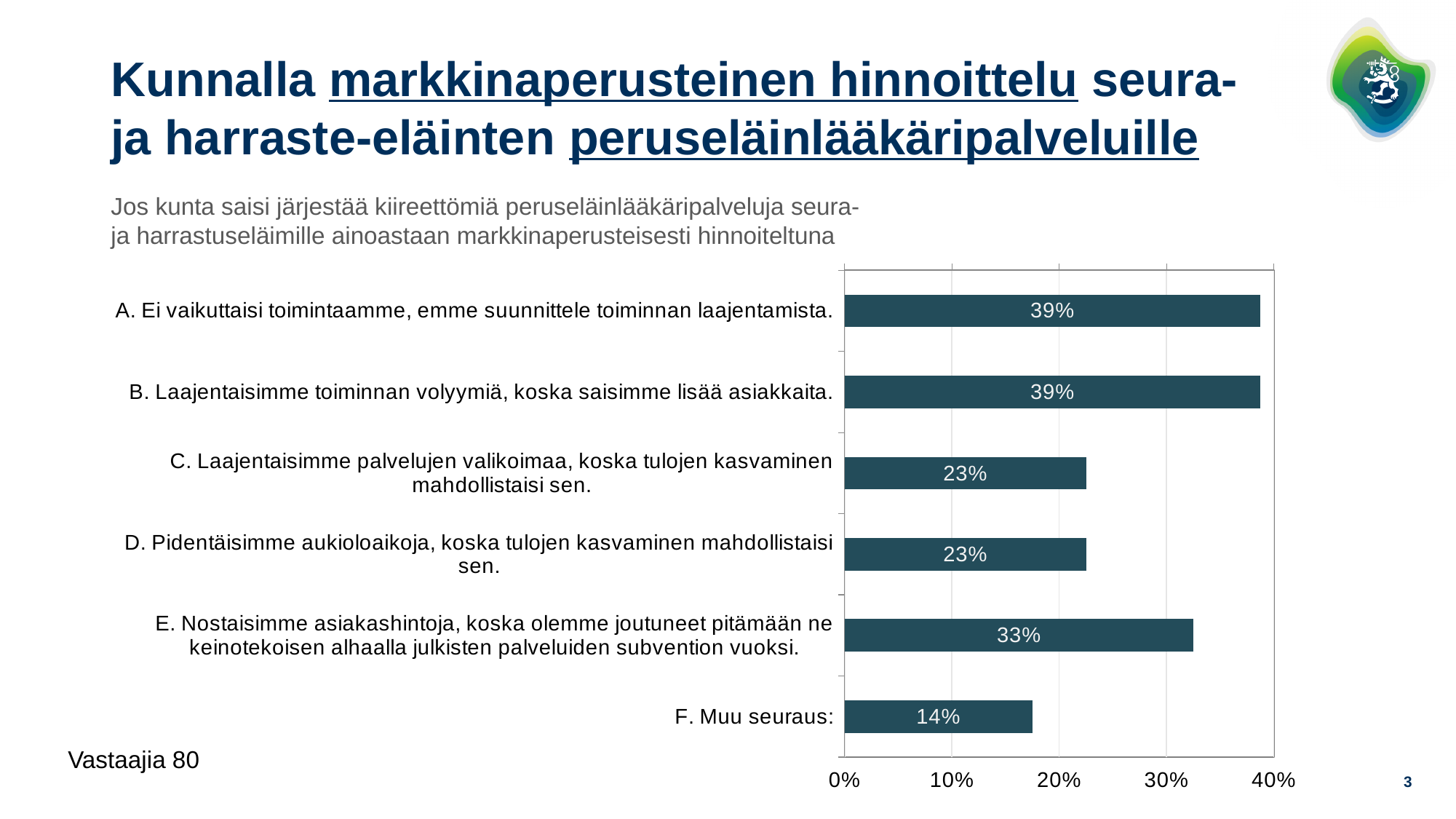
How many respondents does the slide report ("Vastaajia")? 80 What kind of chart is shown on the slide? Bar chart What percentage is shown for option E, "Nostaisimme asiakashintoja..."? 33% Which is larger, the value for option B or the value for option E? Option B How many options (categories) are shown in the chart? 6 Is the value for option E greater or less than 30%? greater Which option has the lowest value? F. Muu seuraus What percentage is shown for option A, "Ei vaikuttaisi toimintaamme..."? 39% What is the value for option C, "Laajentaisimme palvelujen valikoimaa..."? 23% What is the difference between the value for option E and the value for option D? 10% What is the value for option F, "Muu seuraus"? 14% What is the difference between the value for option A and the value for option F? 25%